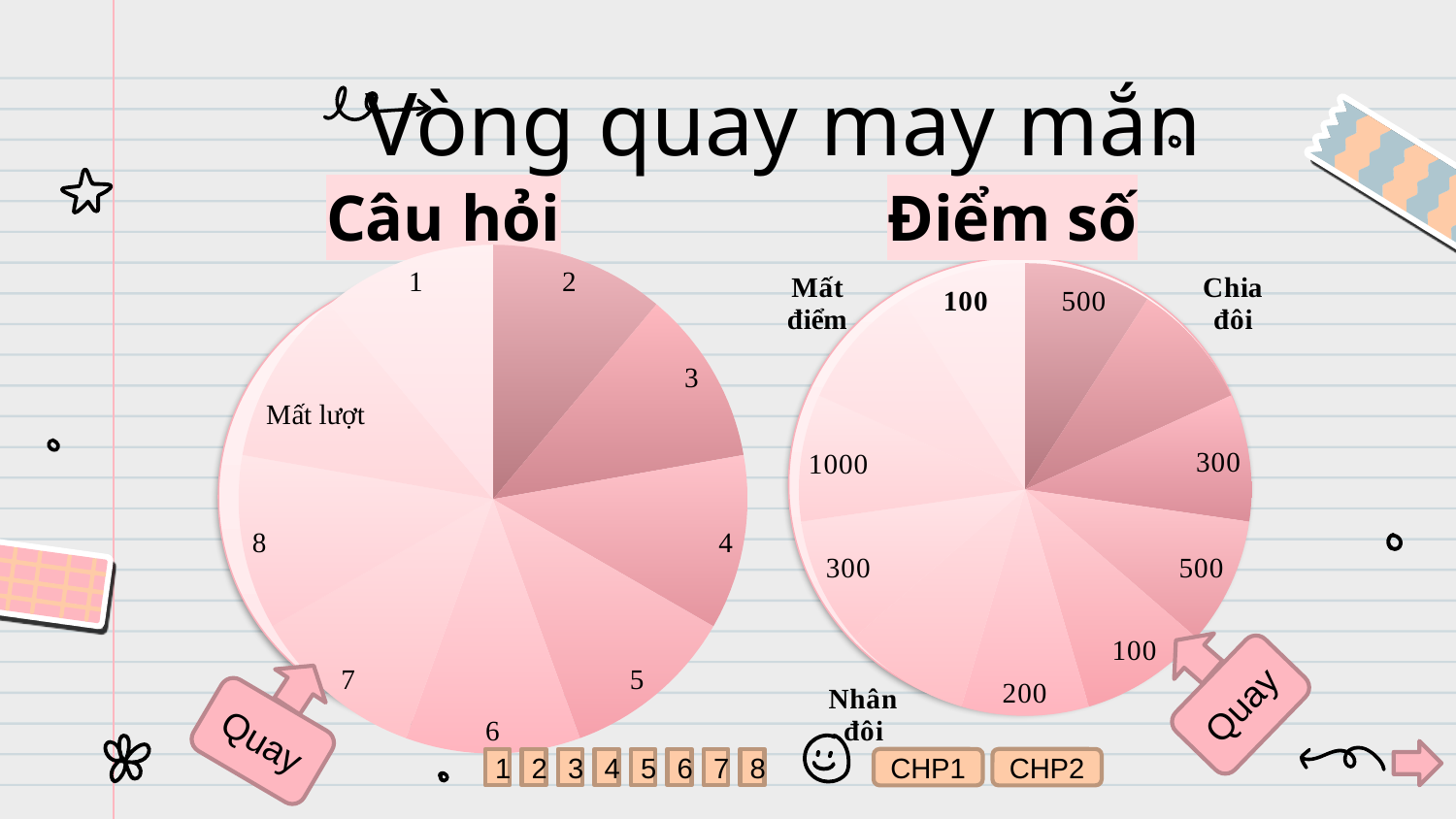
How many slices does the left chart titled "Câu hỏi" have? 9 In the right chart titled "Điểm số", how many slices are labelled "500"? 2 What is the title of the right pie chart? Điểm số What kind of chart is the right chart titled "Điểm số"? pie chart In the right chart titled "Điểm số", how many slices are labelled "300"? 2 In the right chart titled "Điểm số", what is the largest point value printed on a slice? 1000 In the left chart titled "Câu hỏi", which slice is labelled with text rather than a number? Mất lượt In the left chart titled "Câu hỏi", what is the highest number printed on a slice? 8 In the right chart titled "Điểm số", what is the label of the slice immediately clockwise from the "500" slice at the top? Chia đôi What is the title of the left pie chart? Câu hỏi What kind of chart is the left chart titled "Câu hỏi"? pie chart